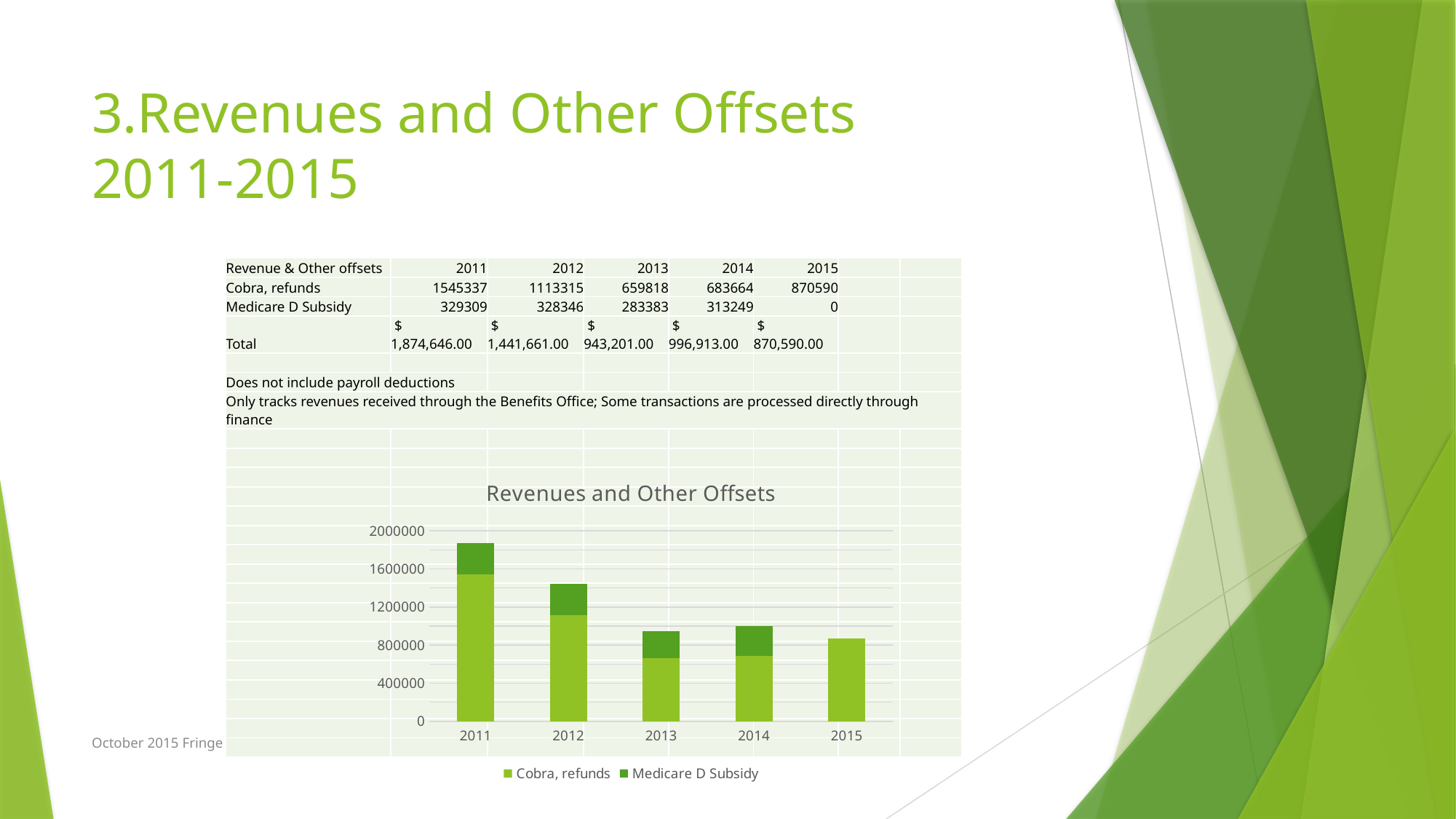
What is the value of Medicare D Subsidy for 2014? 313249 What kind of chart is shown on the slide? bar chart Which year has the highest total of Revenues and Other Offsets? 2011 Which is larger, Medicare D Subsidy in 2011 or in 2013? 2011 Which year has the lowest total of Revenues and Other Offsets? 2015 Is the total stacked bar for 2015 greater or less than 1200000? less What is the value of Cobra, refunds for 2013? 659818 What is the total of the stacked bar for 2011? $ 1,874,646.00 How many series does the chart legend list? 2 What is the title of the chart? Revenues and Other Offsets How many years are shown on the x axis of the chart? 5 What is the difference between Cobra, refunds in 2011 and in 2012? 432022